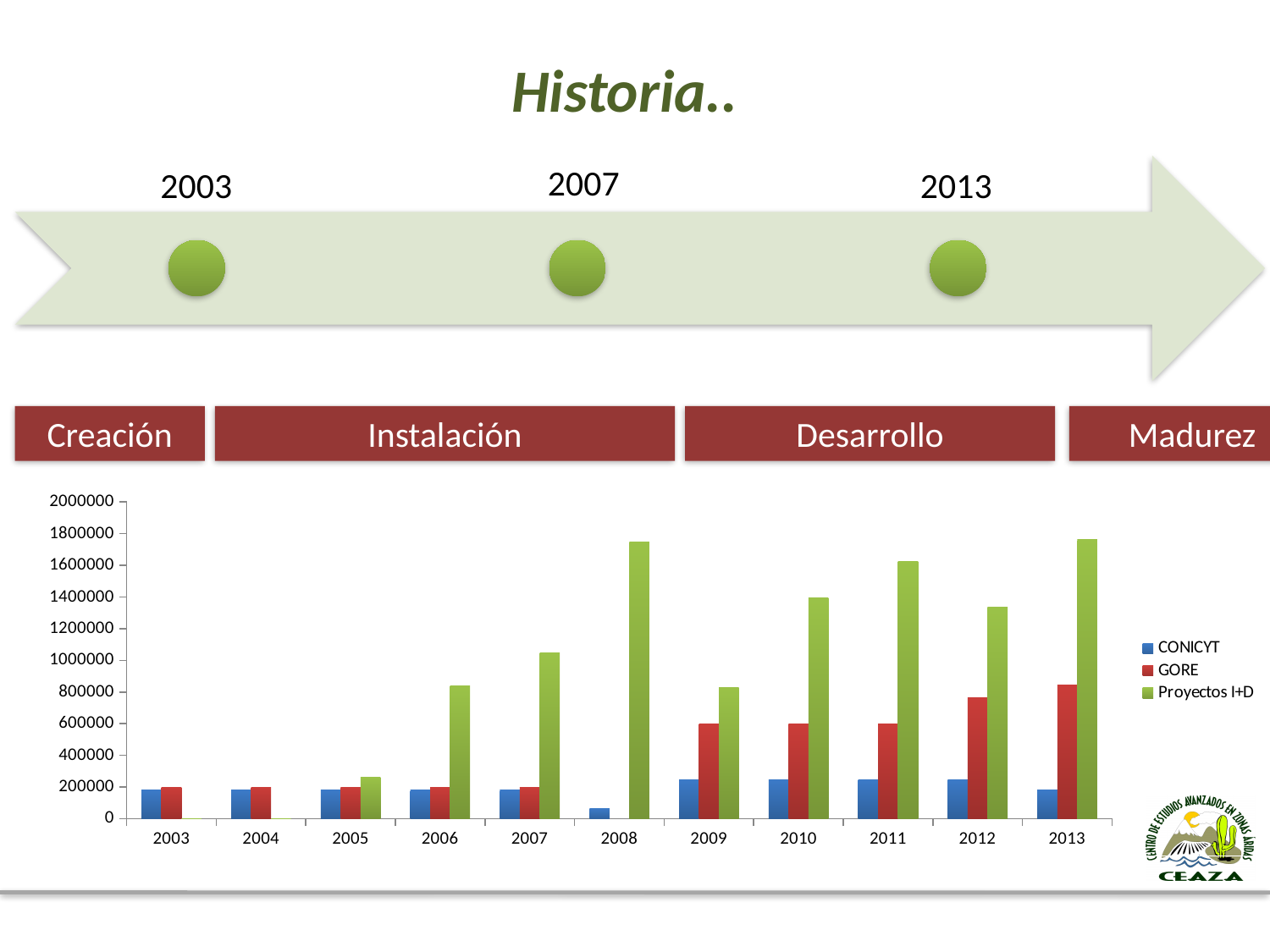
Among the years where Proyectos I+D has a bar, which year has the lowest Proyectos I+D value? 2005 Is the GORE value for 2013 greater or less than 800000? greater Is the CONICYT value for 2008 greater or less than 200000? less Does the GORE value rise or fall from 2011 to 2013? rise Is the Proyectos I+D value for 2011 greater or less than 1400000? greater What kind of chart is shown at the bottom of the slide? bar chart How many years are shown on the x axis of the chart? 11 In which year is the CONICYT value lowest? 2008 In which year is the GORE value highest? 2013 Which colour represents Proyectos I+D in the chart legend? green Which is larger, the Proyectos I+D value for 2011 or for 2012? 2011 How many series does the chart legend list? 3